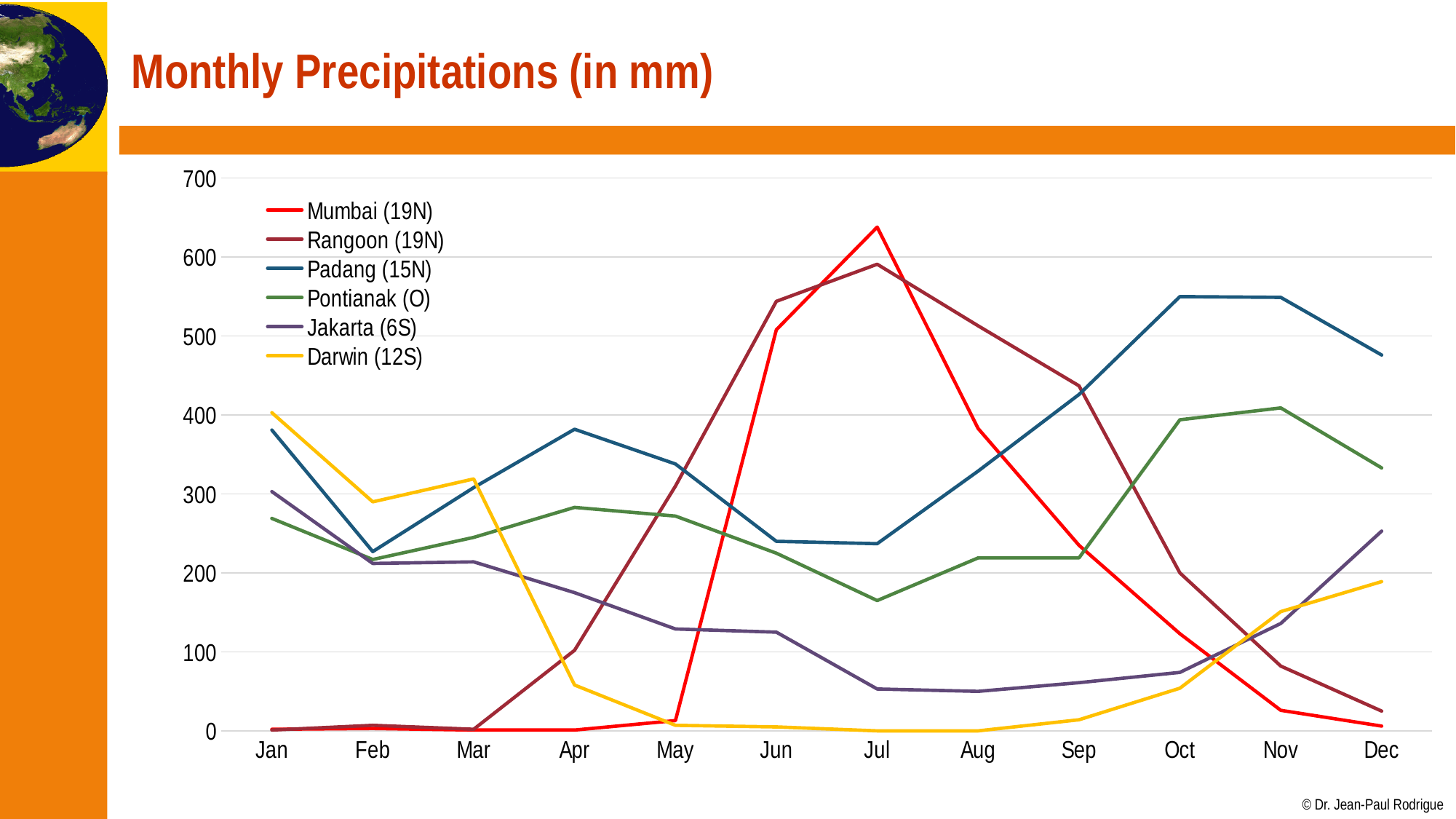
Is the value for Jakarta (6S) in Aug greater or less than 100? less In which month does Mumbai (19N) reach its highest precipitation? Jul Is the value for Pontianak (O) in Jul greater or less than 200? less Is the value for Mumbai (19N) in Jul greater or less than 600? greater Which is larger in Oct, the value for Padang (15N) or the value for Pontianak (O)? Padang (15N) How many months are plotted along the x axis? 12 Which city has the highest precipitation in Nov? Padang (15N) What kind of chart is shown on the slide? line chart Does the Mumbai (19N) line rise or fall from Jul to Dec? fall In which month does Darwin (12S) reach its highest precipitation? Jan How many series does the legend list? 6